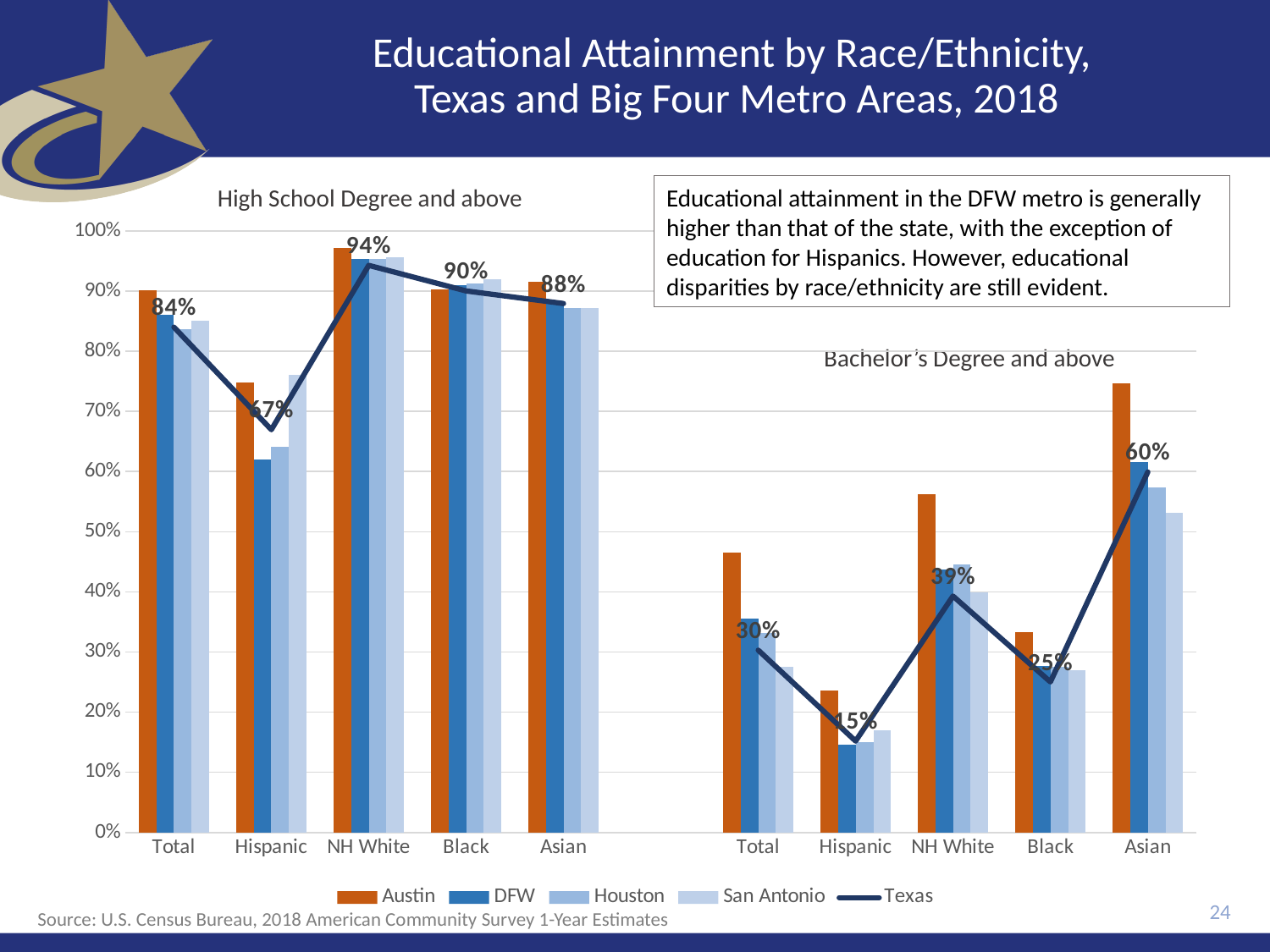
In the Bachelor's Degree and above chart, what is the difference between the Texas values for Asian and Total? 30% In the High School Degree and above chart, what is the Texas value for Hispanic? 67% In the Bachelor's Degree and above chart, is the Austin value for Asian greater or less than 70%? greater In the High School Degree and above chart, which category has the highest Texas value? NH White How many series does the legend list? 5 In the Bachelor's Degree and above chart, which category has the lowest Texas value? Hispanic In the High School Degree and above chart, what is the Texas value for NH White? 94% In the Bachelor's Degree and above chart, what is the Texas value for Asian? 60% In the Bachelor's Degree and above chart, what is the Texas value for Hispanic? 15% In the High School Degree and above chart, is the DFW value for Hispanic greater or less than 70%? less How many categories are shown on the x axis of the Bachelor's Degree and above chart? 5 In the High School Degree and above chart, what is the difference between the Texas values for NH White and Hispanic? 27%